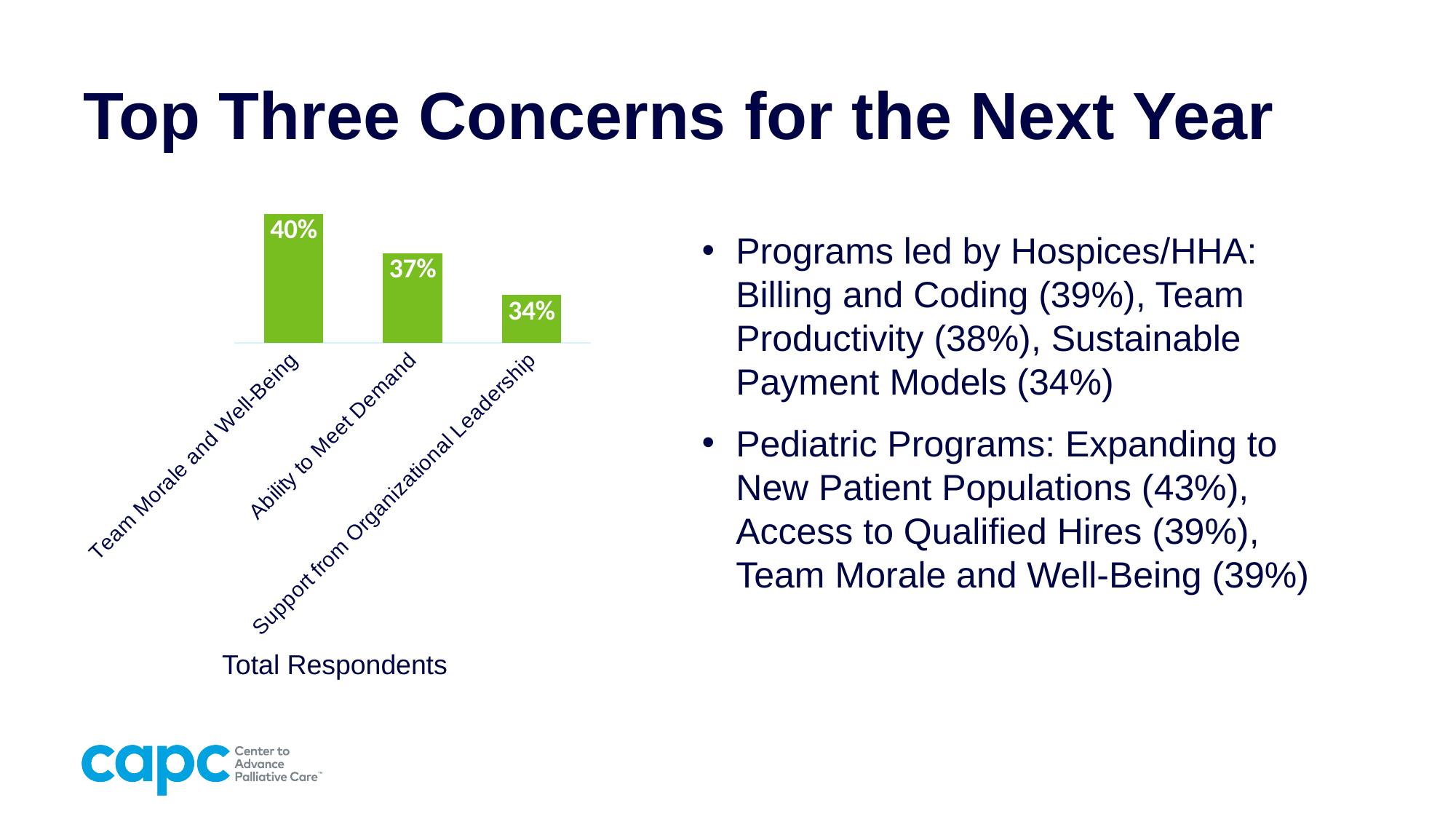
What kind of chart is shown on the slide? Bar chart What is the difference between the values for Team Morale and Well-Being and Support from Organizational Leadership? 6% What is the difference between the values for Team Morale and Well-Being and Ability to Meet Demand? 3% Which category has the lowest value? Support from Organizational Leadership What is the value for Team Morale and Well-Being? 40% Which category has the highest value? Team Morale and Well-Being How many categories are shown in the chart? 3 Which is larger, the value for Ability to Meet Demand or the value for Support from Organizational Leadership? Ability to Meet Demand What label appears below the chart's category axis? Total Respondents What is the value for Support from Organizational Leadership? 34% Do the values rise or fall from left to right across the categories? Fall What is the value for Ability to Meet Demand? 37%